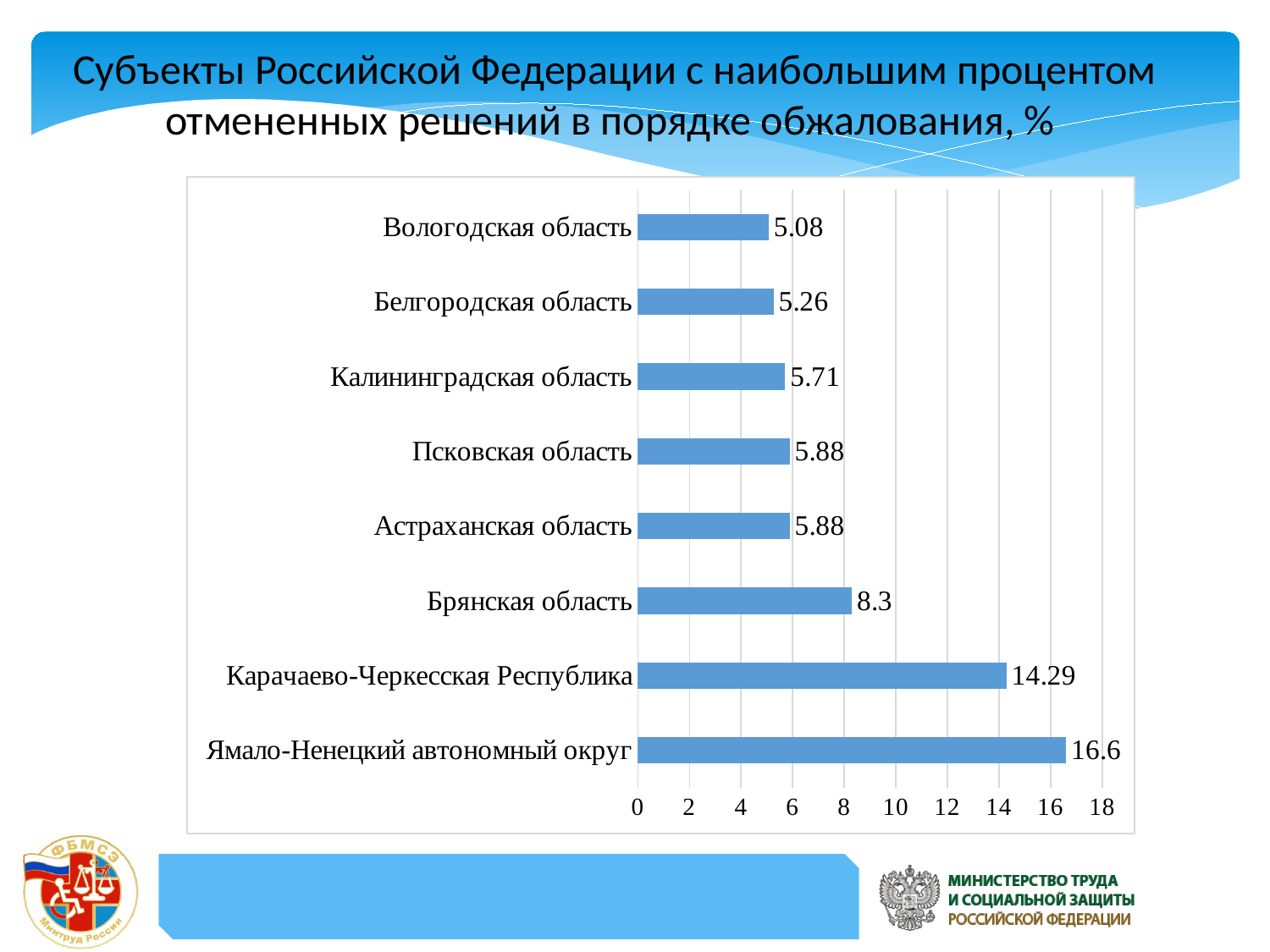
Which region has the highest value on the chart? Ямало-Ненецкий автономный округ Which is larger, the value for Белгородская область or the value for Калининградская область? Калининградская область What is the value for Карачаево-Черкесская Республика? 14.29 What is the difference between the values for Ямало-Ненецкий автономный округ and Карачаево-Черкесская Республика? 2.31 What kind of chart is shown on the slide? bar chart What is the difference between the values for Брянская область and Псковская область? 2.42 What is the value for Калининградская область? 5.71 What is the value for Брянская область? 8.3 Which region has the lowest value on the chart? Вологодская область What is the value for Ямало-Ненецкий автономный округ? 16.6 Is the value for Карачаево-Черкесская Республика greater or less than 12? greater How many regions are shown on the chart? 8